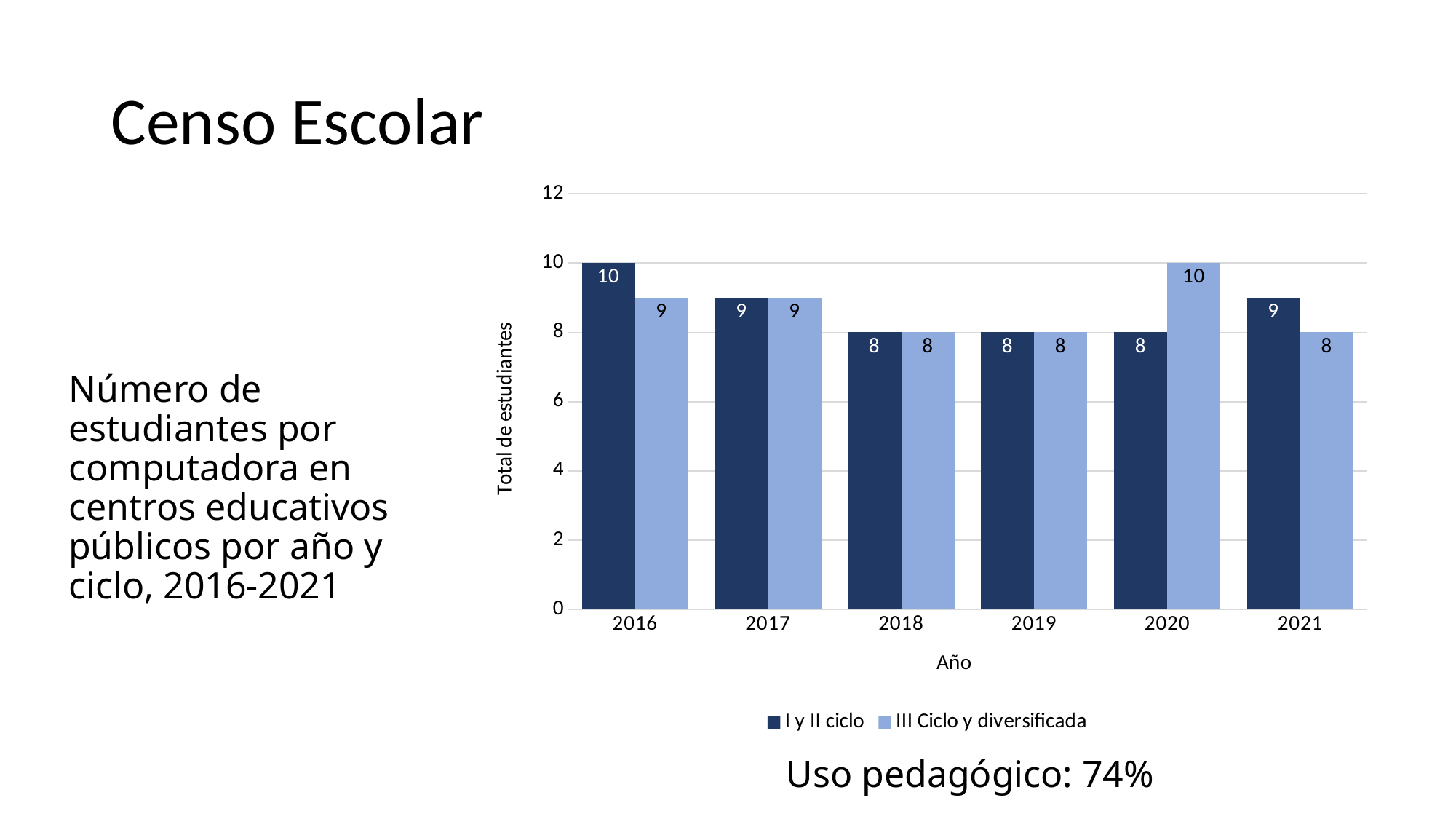
In which year is the 'III Ciclo y diversificada' value highest? 2020 What is the value for 'III Ciclo y diversificada' in 2021? 8 What kind of chart is shown on the slide? Bar chart In which year is the 'I y II ciclo' value highest? 2016 What is the label of the y axis? Total de estudiantes How many years are shown on the x axis? 6 How many series does the legend list? 2 What is the value for 'I y II ciclo' in 2016? 10 What is the value for 'I y II ciclo' in 2019? 8 What is the value for 'III Ciclo y diversificada' in 2020? 10 Which is larger in 2021: 'I y II ciclo' or 'III Ciclo y diversificada'? I y II ciclo What is the difference between the 'III Ciclo y diversificada' value in 2020 and the 'I y II ciclo' value in 2020? 2